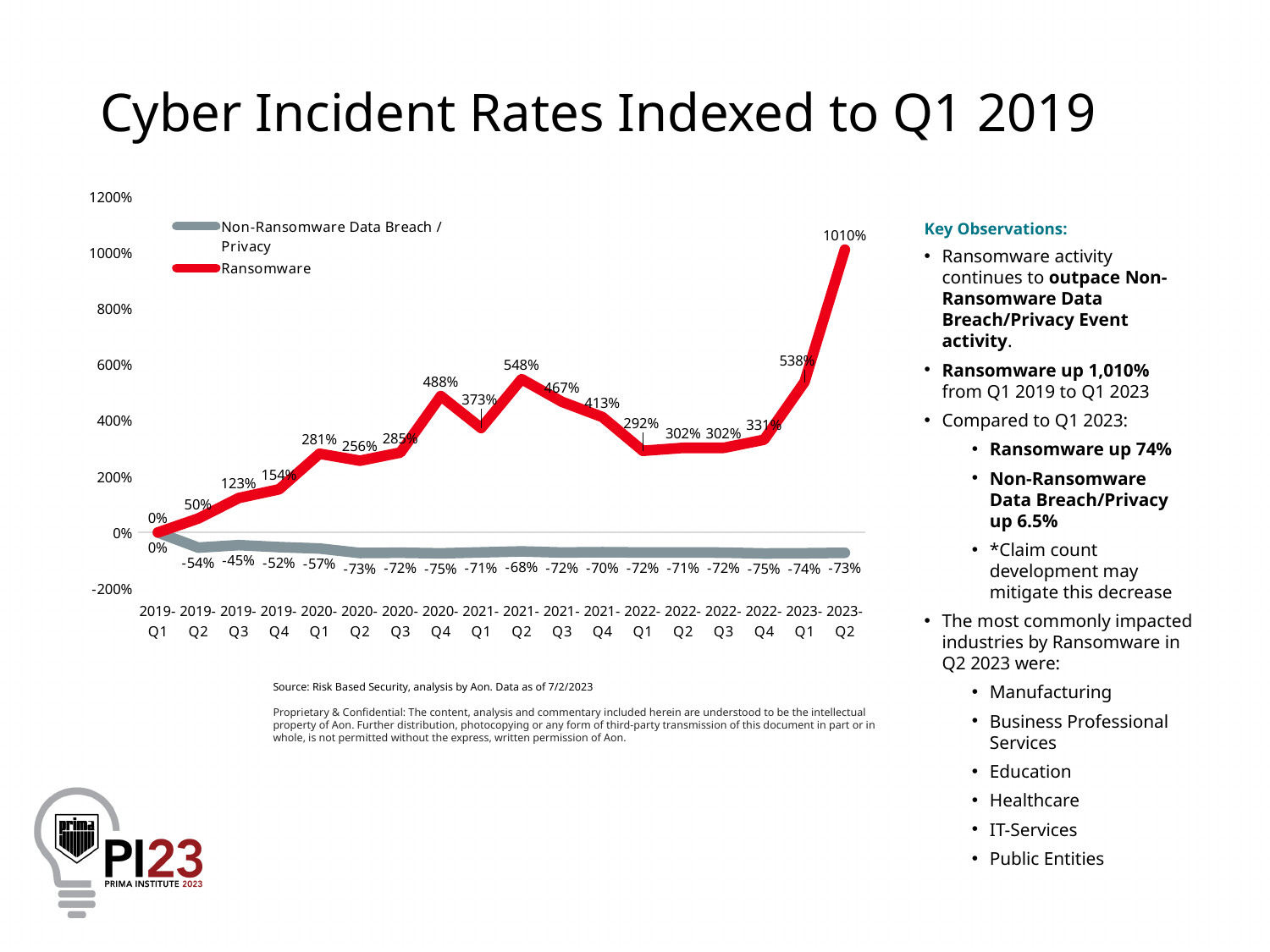
What is the Ransomware value for 2023-Q2? 1010% What is the Non-Ransomware Data Breach / Privacy value for 2019-Q3? -45% What is the difference between the Ransomware values for 2023-Q2 and 2023-Q1? 472% What is the Ransomware value for 2021-Q2? 548% What type of chart is shown on the slide? Line chart Which series is drawn in red? Ransomware Does the Ransomware series rise or fall from 2022-Q4 to 2023-Q2? Rise How many series does the legend list? 2 What is the Non-Ransomware Data Breach / Privacy value for 2020-Q4? -75% In which quarter does the Ransomware series reach its highest value? 2023-Q2 Which is larger, the Ransomware value for 2020-Q4 or for 2021-Q1? 2020-Q4 How many quarters are plotted along the x axis? 18